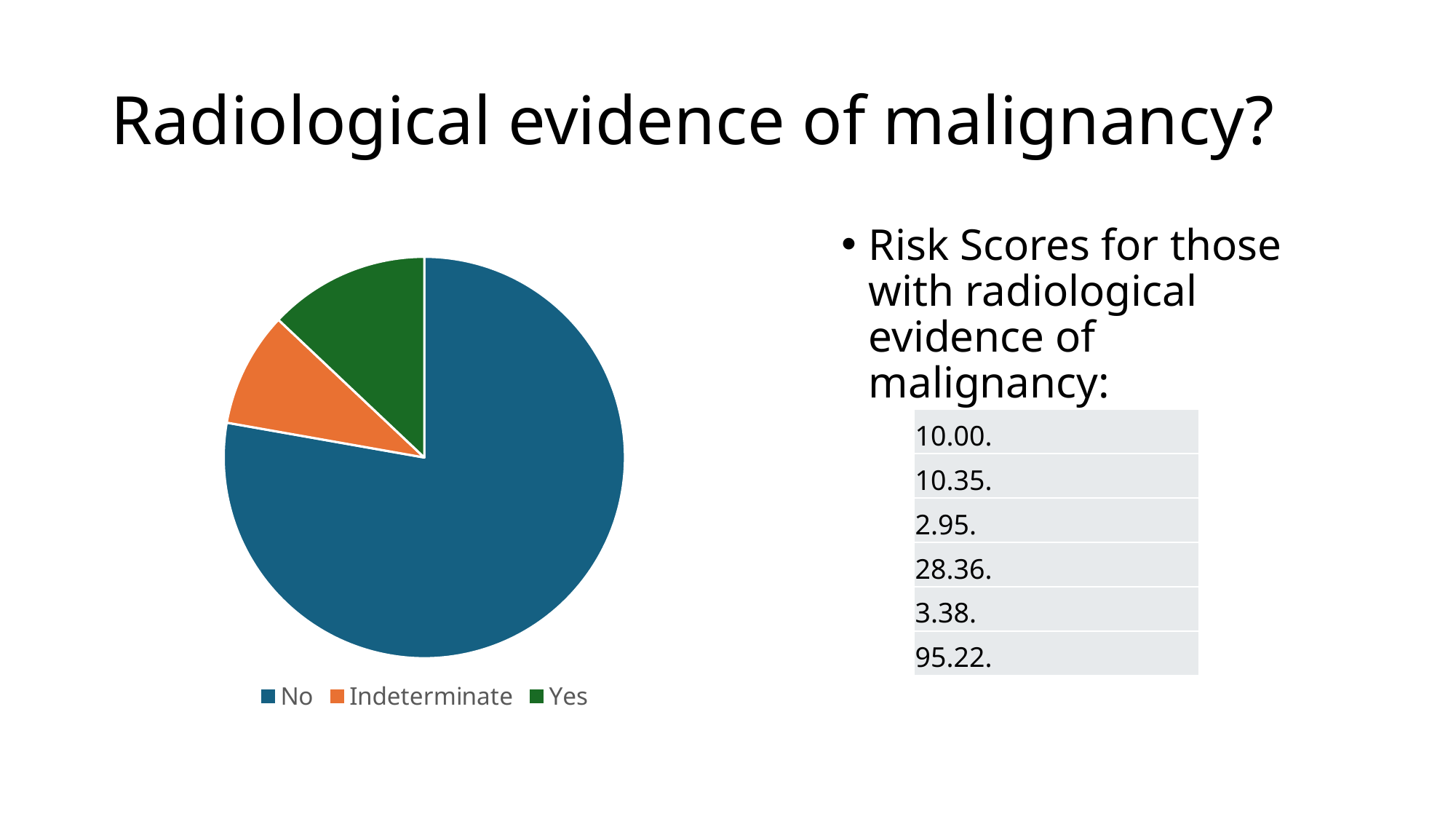
How many entries does the legend of the pie chart list? 3 What colour is the Indeterminate slice in the pie chart? orange Which slice is larger in the pie chart, No or Yes? No Which category has the smallest slice in the pie chart? Indeterminate How many slices does the pie chart have? 3 Which slice is larger in the pie chart, Yes or Indeterminate? Yes What kind of chart is shown on the slide? pie chart Which category is shown in green in the pie chart? Yes Which category has the largest slice in the pie chart? No Does the No slice take up more or less than half of the pie chart? more